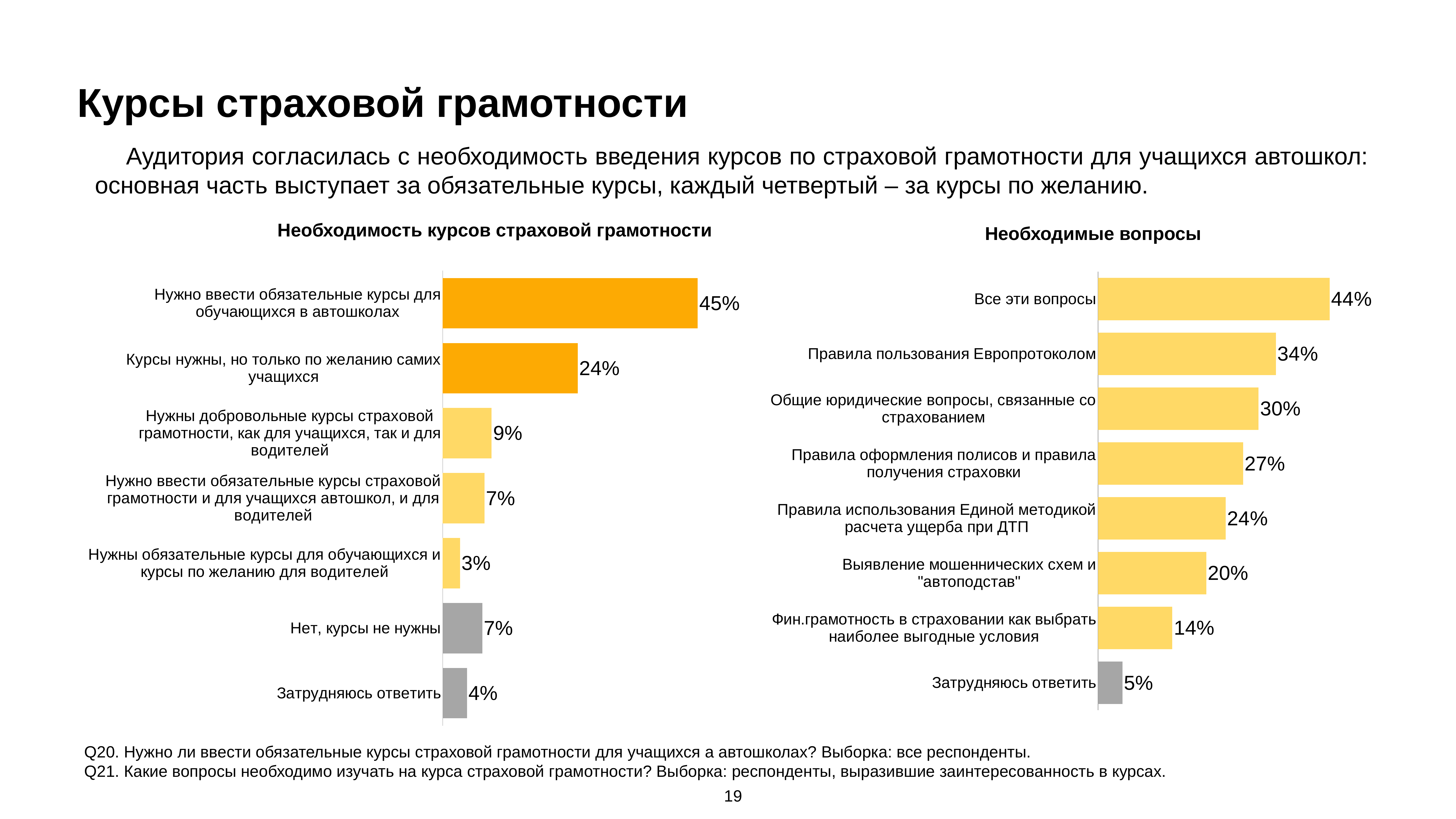
How many categories are shown in the chart 'Необходимые вопросы'? 8 In the chart 'Необходимые вопросы', what is the difference between 'Все эти вопросы' and 'Затрудняюсь ответить'? 39 percentage points In the chart 'Необходимые вопросы', which is larger: 'Общие юридические вопросы, связанные со страхованием' or 'Правила оформления полисов и правила получения страховки'? Общие юридические вопросы, связанные со страхованием In the chart 'Необходимые вопросы', which category has the highest value? Все эти вопросы In the chart 'Необходимость курсов страховой грамотности', what is the difference between 'Нужно ввести обязательные курсы для обучающихся в автошколах' and 'Курсы нужны, но только по желанию самих учащихся'? 21 percentage points In the chart 'Необходимость курсов страховой грамотности', what is the value for 'Нет, курсы не нужны'? 7% In the chart 'Необходимые вопросы', what is the value for 'Правила пользования Европротоколом'? 34% How many categories are shown in the chart 'Необходимость курсов страховой грамотности'? 7 In the chart 'Необходимость курсов страховой грамотности', what is the value for 'Нужно ввести обязательные курсы для обучающихся в автошколах'? 45% In the chart 'Необходимость курсов страховой грамотности', which category has the lowest value? Нужны обязательные курсы для обучающихся и курсы по желанию для водителей What type of chart is 'Необходимые вопросы'? Bar chart In the chart 'Необходимые вопросы', what is the value for 'Выявление мошеннических схем и "автоподстав"'? 20%